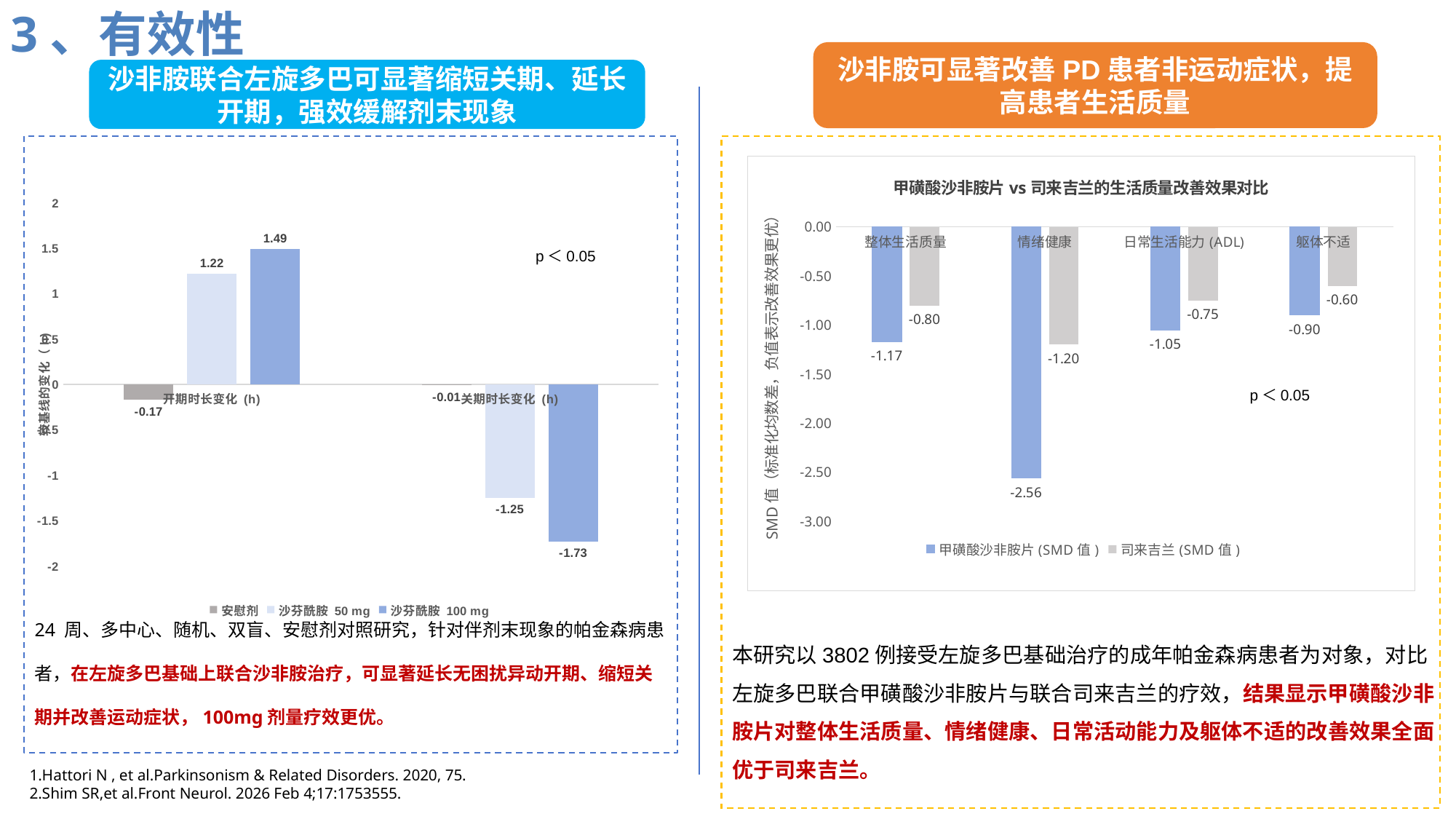
In the left chart, how many series does the legend list? 3 In the left chart, what is the value for 沙芬酰胺 100 mg in the 开期时长变化 (h) category? 1.49 In the chart titled 甲磺酸沙非胺片 vs 司来吉兰的生活质量改善效果对比, what is the difference between the 甲磺酸沙非胺片 (SMD 值) and 司来吉兰 (SMD 值) values in the 日常生活能力 (ADL) category? 0.30 In the chart titled 甲磺酸沙非胺片 vs 司来吉兰的生活质量改善效果对比, what is the value for 司来吉兰 (SMD 值) in the 躯体不适 category? -0.60 In the left chart, what is the value for 安慰剂 in the 开期时长变化 (h) category? -0.17 In the left chart, what is the difference between the 沙芬酰胺 100 mg and 沙芬酰胺 50 mg values in the 开期时长变化 (h) category? 0.27 In the chart titled 甲磺酸沙非胺片 vs 司来吉兰的生活质量改善效果对比, what is the value for 甲磺酸沙非胺片 (SMD 值) in the 情绪健康 category? -2.56 In the chart titled 甲磺酸沙非胺片 vs 司来吉兰的生活质量改善效果对比, how many categories are shown on the x axis? 4 In the left chart, which series has the lowest value in the 关期时长变化 (h) category? 沙芬酰胺 100 mg What type of chart is the chart titled 甲磺酸沙非胺片 vs 司来吉兰的生活质量改善效果对比? Bar chart In the left chart, what is the value for 沙芬酰胺 50 mg in the 关期时长变化 (h) category? -1.25 In the chart titled 甲磺酸沙非胺片 vs 司来吉兰的生活质量改善效果对比, which category has the lowest value for 甲磺酸沙非胺片 (SMD 值)? 情绪健康